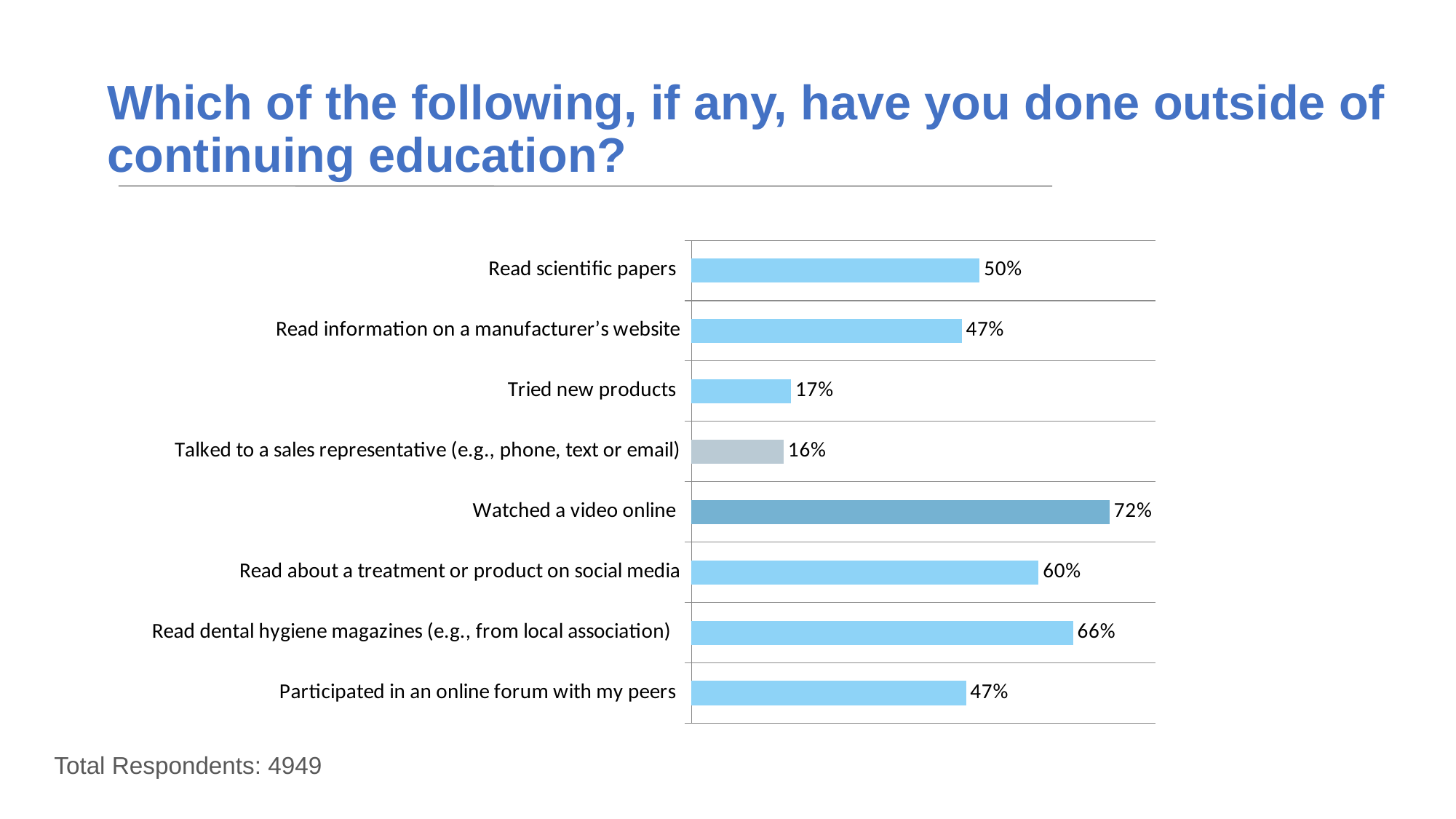
What kind of chart is shown on the slide? Bar chart How many total respondents are noted on the slide? 4949 What percentage of respondents said they tried new products? 17% Which activity has the lowest percentage of respondents? Talked to a sales representative (e.g., phone, text or email) Which activity has the highest percentage of respondents? Watched a video online What is the difference in percentage points between 'Read about a treatment or product on social media' and 'Tried new products'? 43 How many activities (categories) are shown in the chart? 8 What is the difference in percentage points between 'Watched a video online' and 'Read scientific papers'? 22 Which is larger: the value for 'Read scientific papers' or the value for 'Read information on a manufacturer's website'? Read scientific papers Which bar is shown in a grey colour rather than blue? Talked to a sales representative (e.g., phone, text or email) What percentage of respondents said they watched a video online? 72% What percentage of respondents said they read dental hygiene magazines (e.g., from local association)? 66%